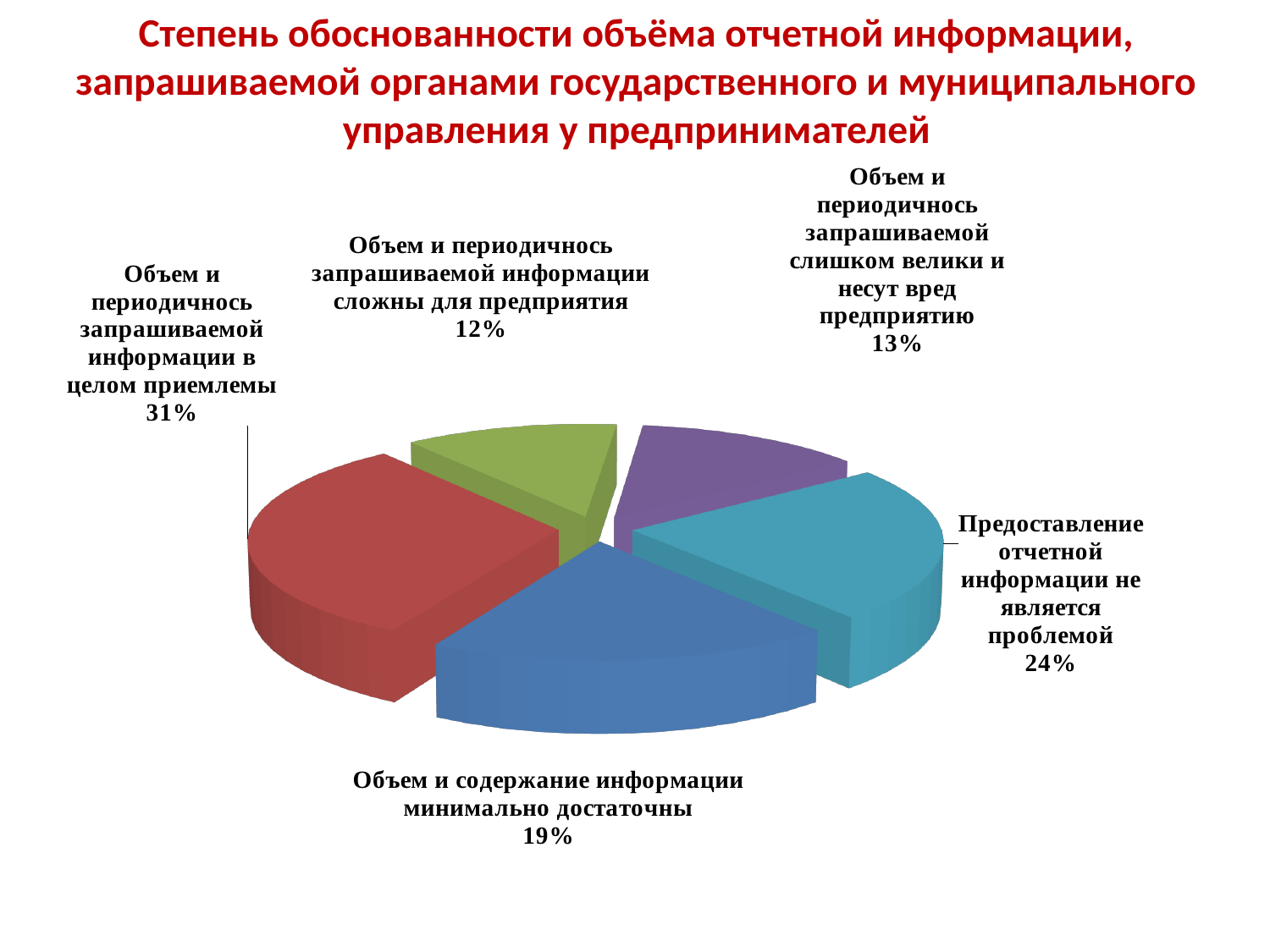
What percentage corresponds to "Предоставление отчетной информации не является проблемой"? 24% What percentage corresponds to "Объем и периодичность запрашиваемой информации сложны для предприятия"? 12% What share of respondents said the volume and frequency of requested information are generally acceptable ("Объем и периодичность запрашиваемой информации в целом приемлемы")? 31% What percentage corresponds to "Объем и периодичность запрашиваемой слишком велики и несут вред предприятию"? 13% What is the difference in percentage points between "в целом приемлемы" (31%) and "не является проблемой" (24%)? 7 Which category has the largest share of the pie? Объем и периодичность запрашиваемой информации в целом приемлемы What percentage corresponds to "Объем и содержание информации минимально достаточны"? 19% What colour is the slice representing 31%? Red What type of chart is shown on the slide? Pie chart How many slices does the pie chart have? 5 Which category has the smallest share of the pie? Объем и периодичность запрашиваемой информации сложны для предприятия Which is larger: the share for "минимально достаточны" or the share for "слишком велики и несут вред предприятию"? минимально достаточны